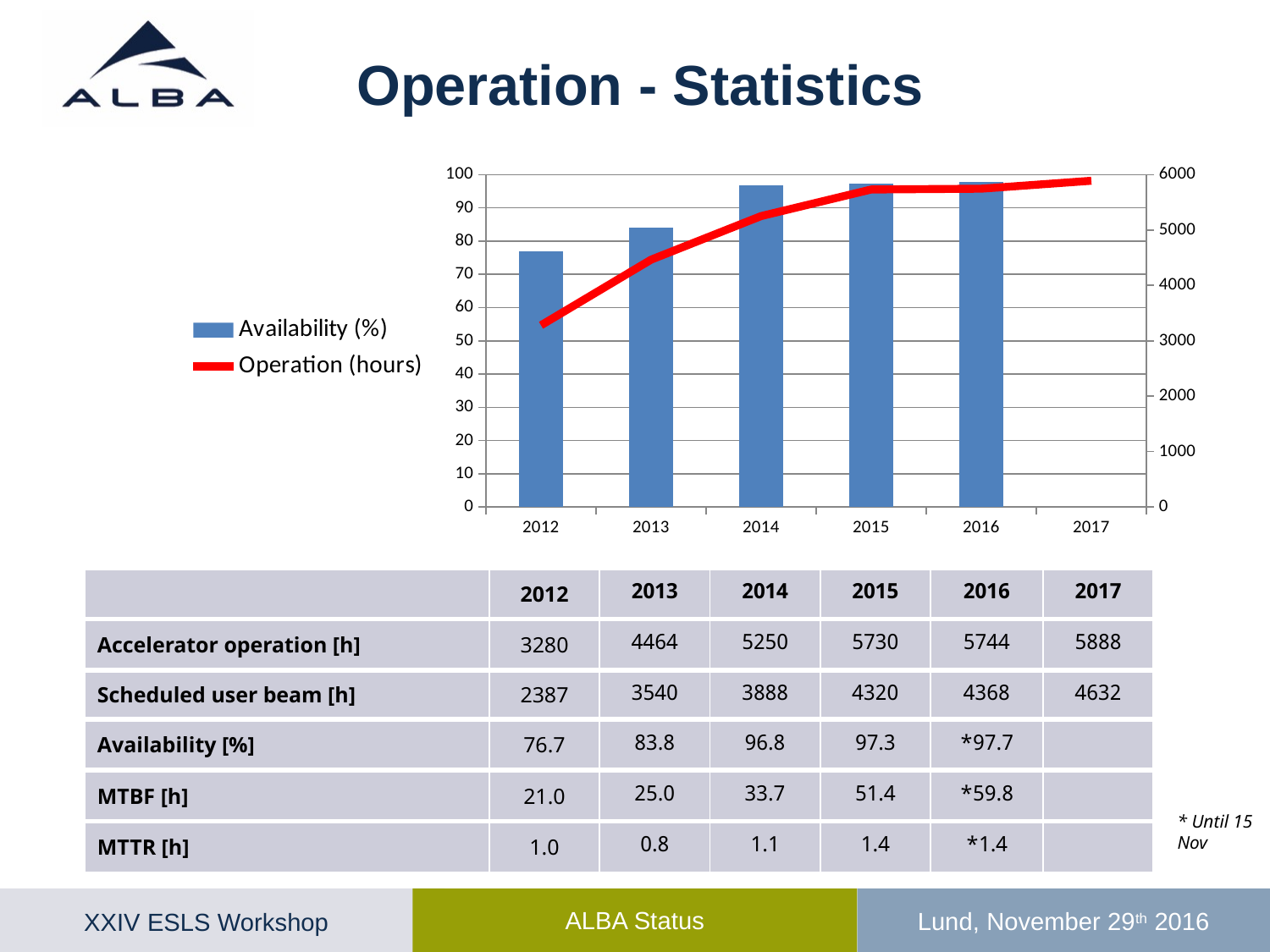
What kind of chart is shown on the slide? A combined bar and line chart Is the Availability (%) value for 2012 greater or less than 80? less Does the Operation (hours) line rise or fall from 2012 to 2017? Rises How many years are shown on the x axis of the chart? 6 Which year has the lowest Availability (%) bar in the chart? 2012 Which is larger in the chart, the Availability (%) bar for 2013 or for 2014? 2014 Is the Availability (%) value for 2014 greater or less than 90? greater What is the Availability (%) value for 2012, as printed in the table below the chart? 76.7 Is the Operation (hours) value for 2015 greater or less than 5000? greater Which series is drawn as a red line in the chart? Operation (hours) How many series does the chart legend list? 2